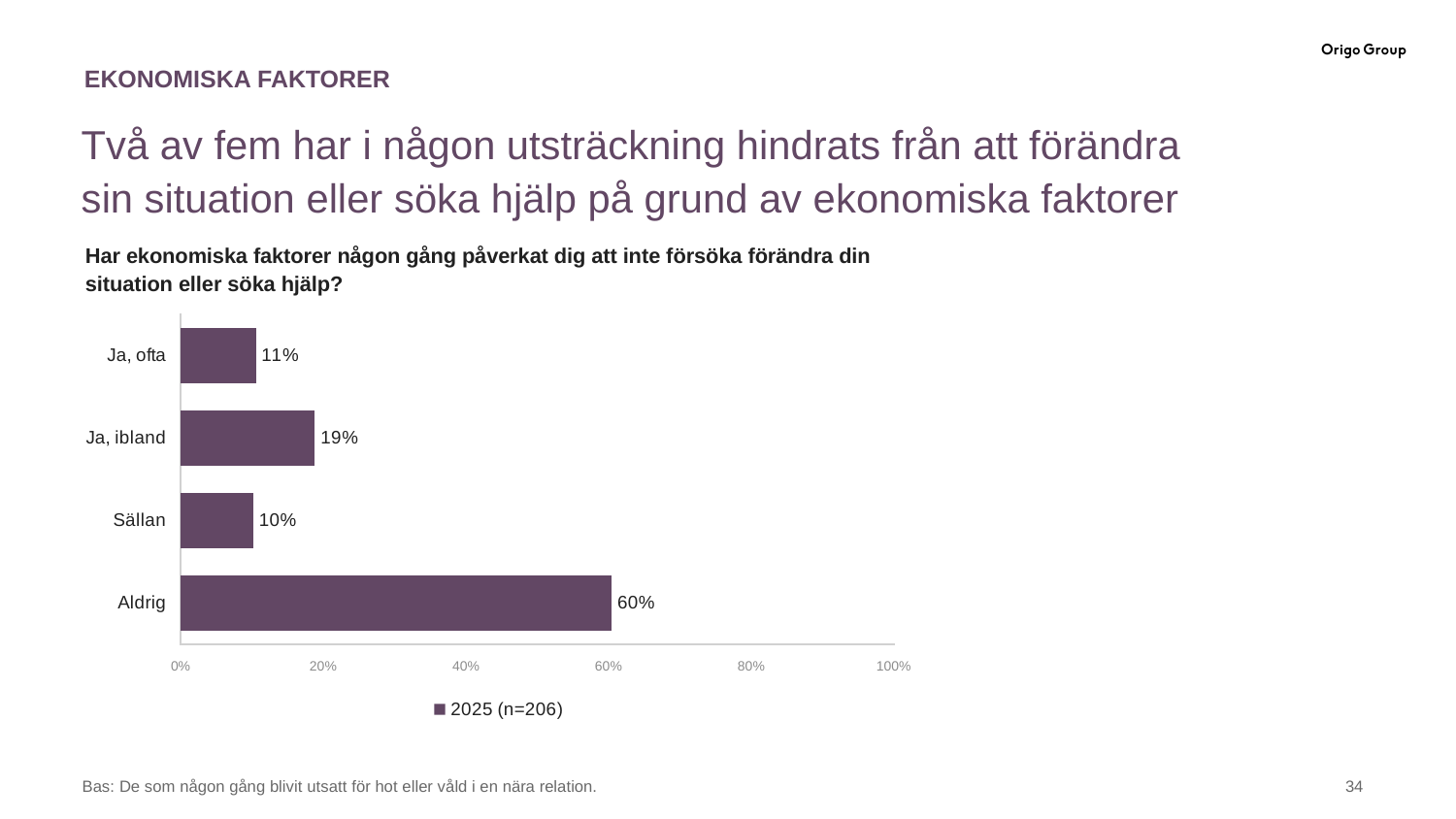
What series does the legend list? 2025 (n=206) What kind of chart is shown on the slide? Bar chart What is the value for "Ja, ofta"? 11% Is the value for "Aldrig" greater or less than 40%? greater Which category has the highest value? Aldrig Which is larger, the value for "Ja, ibland" or the value for "Ja, ofta"? Ja, ibland What is the value for "Sällan"? 10% What is the value for "Ja, ibland"? 19% Which category has the lowest value? Sällan What is the difference between the values for "Aldrig" and "Ja, ibland"? 41 percentage points What is the value for "Aldrig"? 60% How many categories are shown in the chart? 4